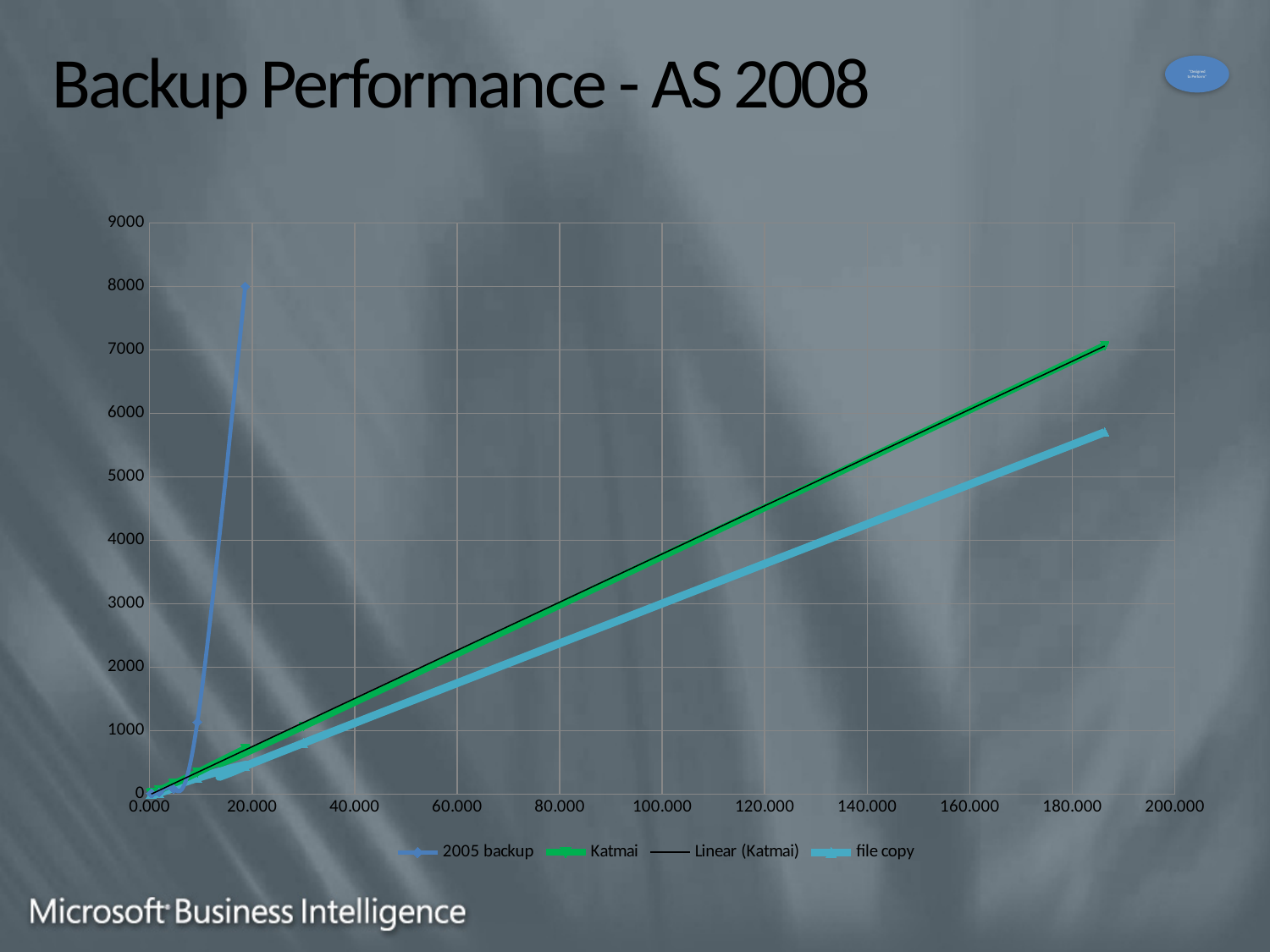
What is the title of the chart on the slide? Backup Performance - AS 2008 Which series reaches the highest value on the chart? 2005 backup What kind of chart is shown on the slide? line chart Which series are listed in the chart legend? 2005 backup, Katmai, Linear (Katmai), file copy Does the file copy series rise or fall as the x-axis value increases? rise What is the highest tick value shown on the vertical axis? 9000 Is the value of the Katmai series at an x value of 180.000 greater or less than 6000? greater At an x value of 100.000, which series is higher: Katmai or file copy? Katmai Is the highest value reached by the 2005 backup series greater or less than 7000? greater Does the Katmai series rise or fall as the x-axis value increases? rise Is the value of the file copy series at an x value of 180.000 greater or less than 6000? less How many series does the chart legend list? 4